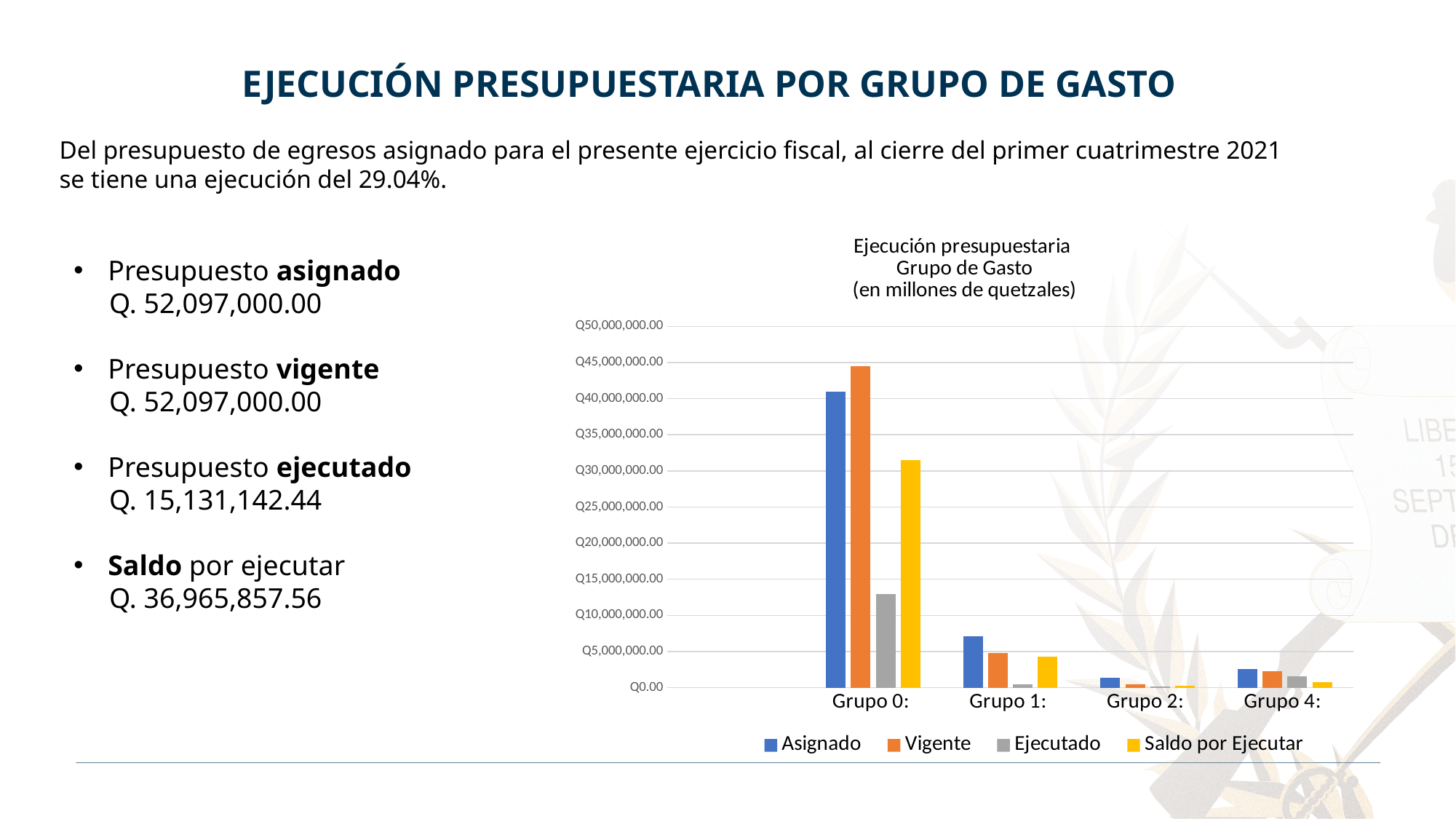
For Grupo 0, which is larger: the Vigente value or the Asignado value? Vigente Is the Vigente value for Grupo 0 greater or less than Q40,000,000.00? greater Is the Ejecutado value for Grupo 0 greater or less than Q15,000,000.00? less What kind of chart is shown on the slide? Bar chart Which series is shown in yellow in the chart legend? Saldo por Ejecutar Which group has the lowest Asignado value in the chart? Grupo 2: Which group has the highest Vigente value in the chart? Grupo 0: How many series does the chart legend list? 4 How many groups (categories) are shown on the x axis of the chart? 4 Is the Saldo por Ejecutar value for Grupo 0 greater or less than Q30,000,000.00? greater For Grupo 1, which is larger: the Asignado value or the Ejecutado value? Asignado